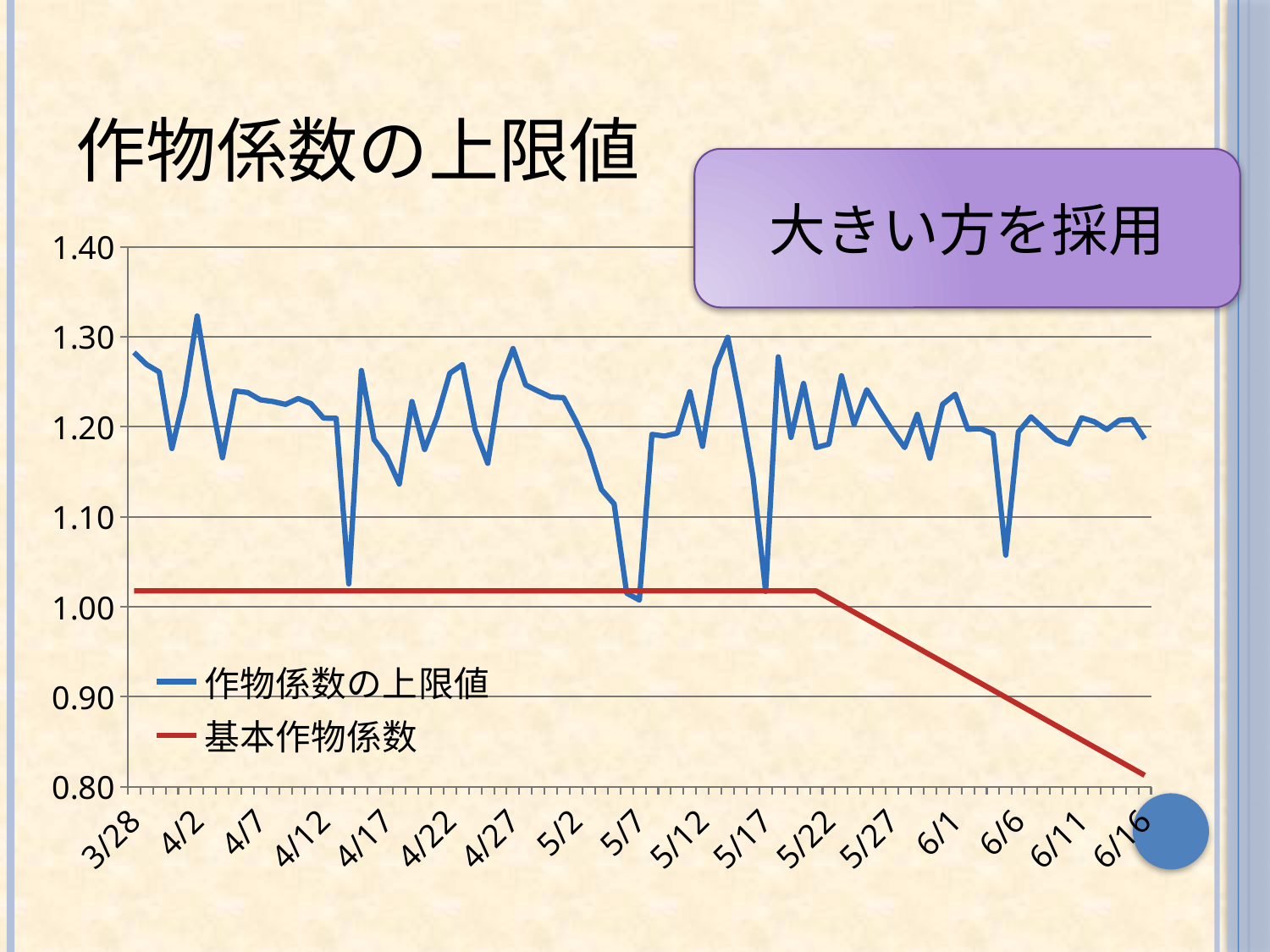
How many series does the legend list? 2 Which series is drawn in red in the legend? 基本作物係数 What is the title of the chart? 作物係数の上限値 What kind of chart is shown on the slide? line chart Is the value of 基本作物係数 at 6/16 greater or less than 0.90? less At 6/16, which series has the larger value, 作物係数の上限値 or 基本作物係数? 作物係数の上限値 Is the value of 作物係数の上限値 at 3/28 greater or less than 1.20? greater Is the value of 基本作物係数 at 5/27 greater or less than 1.10? less What is the highest value shown on the y axis? 1.40 How many date labels are shown on the x axis? 17 Does the 基本作物係数 line rise or fall between 5/22 and 6/16? fall